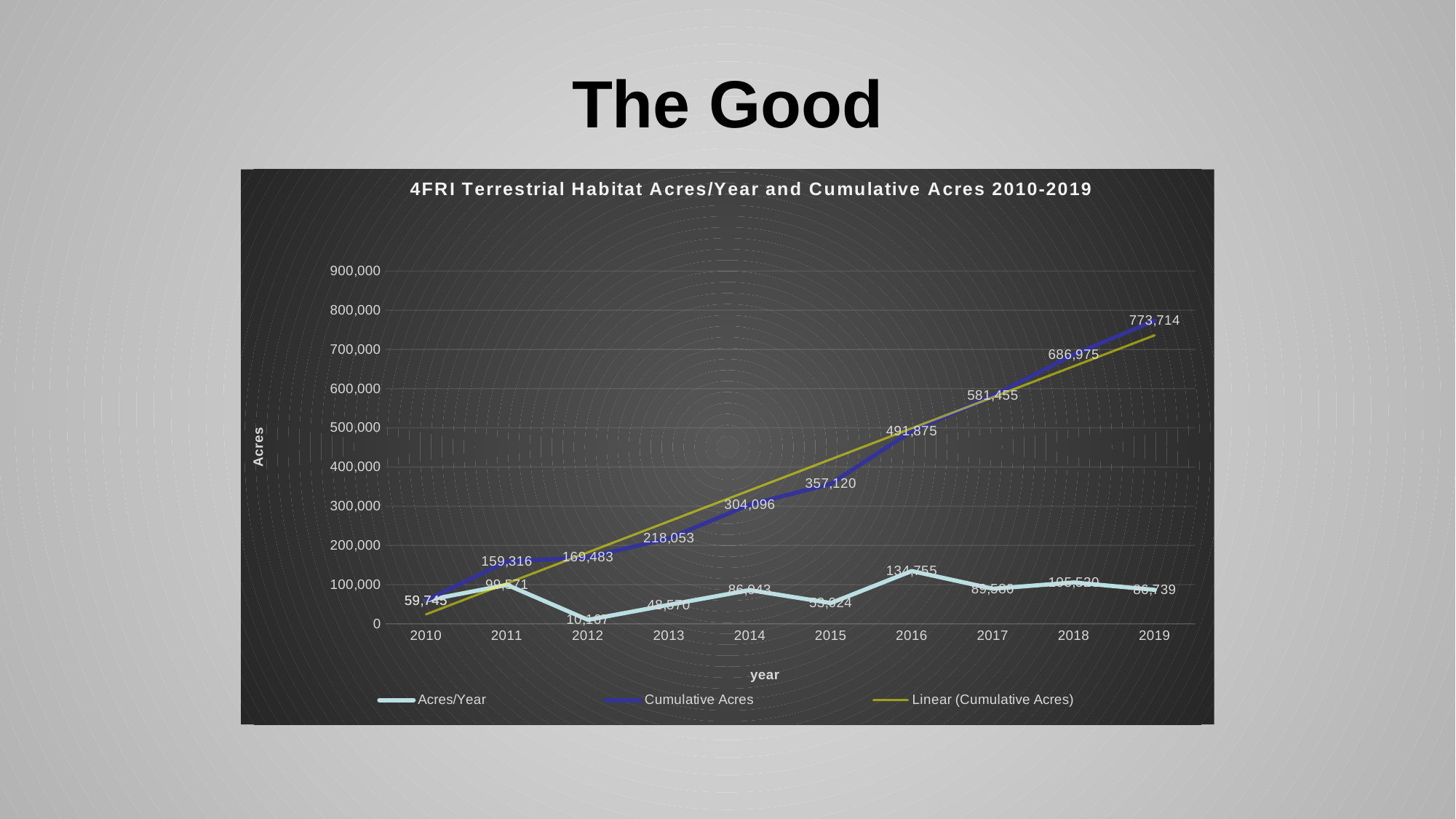
How many years are shown on the x axis? 10 What is the difference between the Cumulative Acres values for 2019 and 2018? 86,739 What is the Cumulative Acres value for 2015? 357,120 Which year has the larger Acres/Year value, 2013 or 2014? 2014 How many entries does the legend list? 3 Is the Cumulative Acres value for 2016 greater or less than 400,000? greater What is the Acres/Year value for 2012? 10,167 Does the Cumulative Acres series rise or fall from 2010 to 2019? rises What kind of chart is shown on the slide? line chart In which year is the Acres/Year value highest? 2016 In which year is the Acres/Year value lowest? 2012 What is the Cumulative Acres value for 2019? 773,714